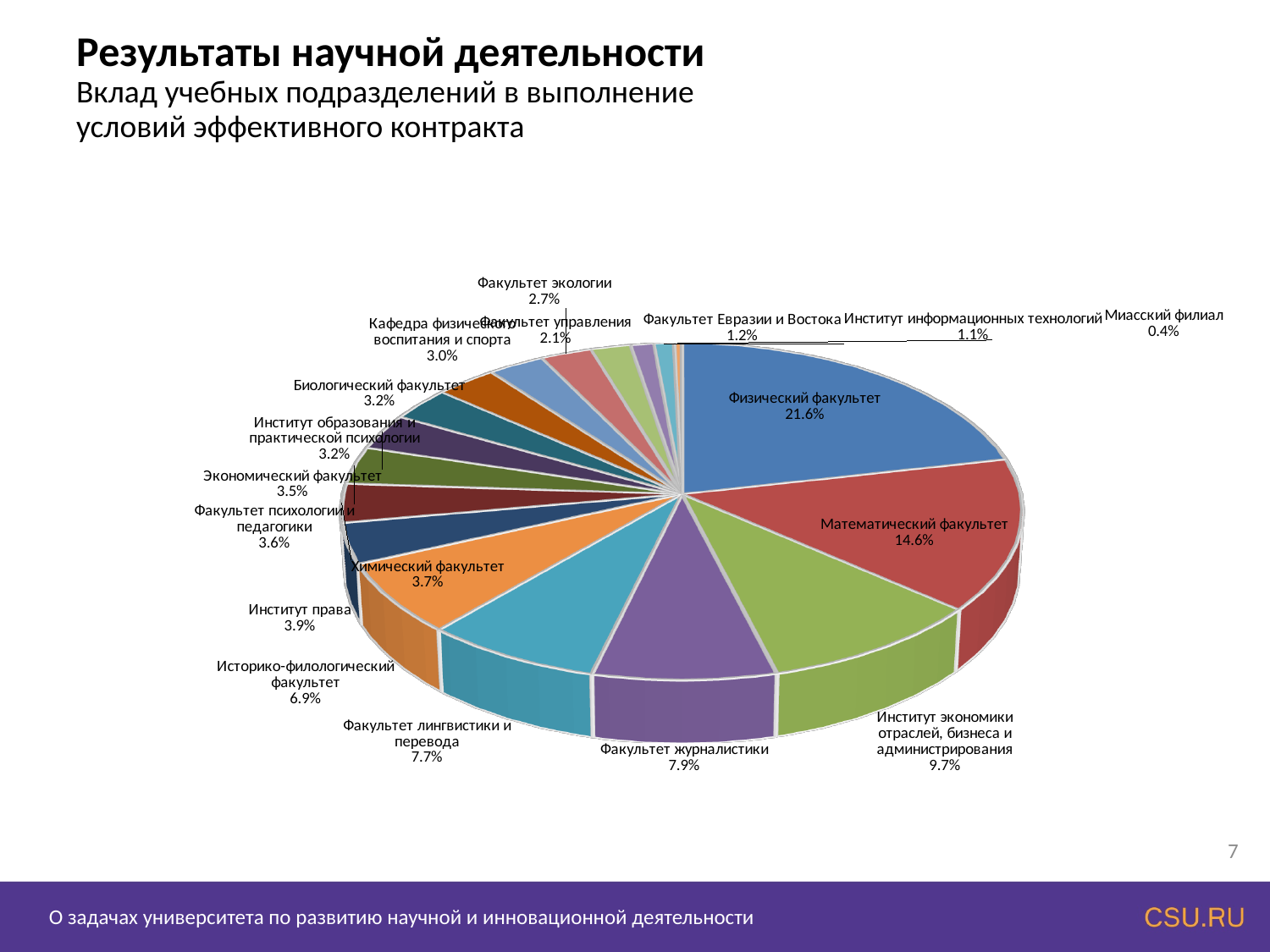
Which category has the smallest slice of the pie? Миасский филиал What is the value shown for Историко-филологический факультет? 6.9% Which category has the largest slice of the pie? Физический факультет How many categories (slices) does the pie chart have? 18 What is the value shown for Институт права? 3.9% What is the value shown for Математический факультет? 14.6% What share of the pie does Физический факультет have? 21.6% What is the difference between the values for Физический факультет and Математический факультет? 7.0% What is the value shown for Факультет журналистики? 7.9% What is the value shown for Институт экономики отраслей, бизнеса и администрирования? 9.7% Which is larger, the value for Факультет лингвистики и перевода or the value for Историко-филологический факультет? Факультет лингвистики и перевода What kind of chart is shown on the slide? pie chart